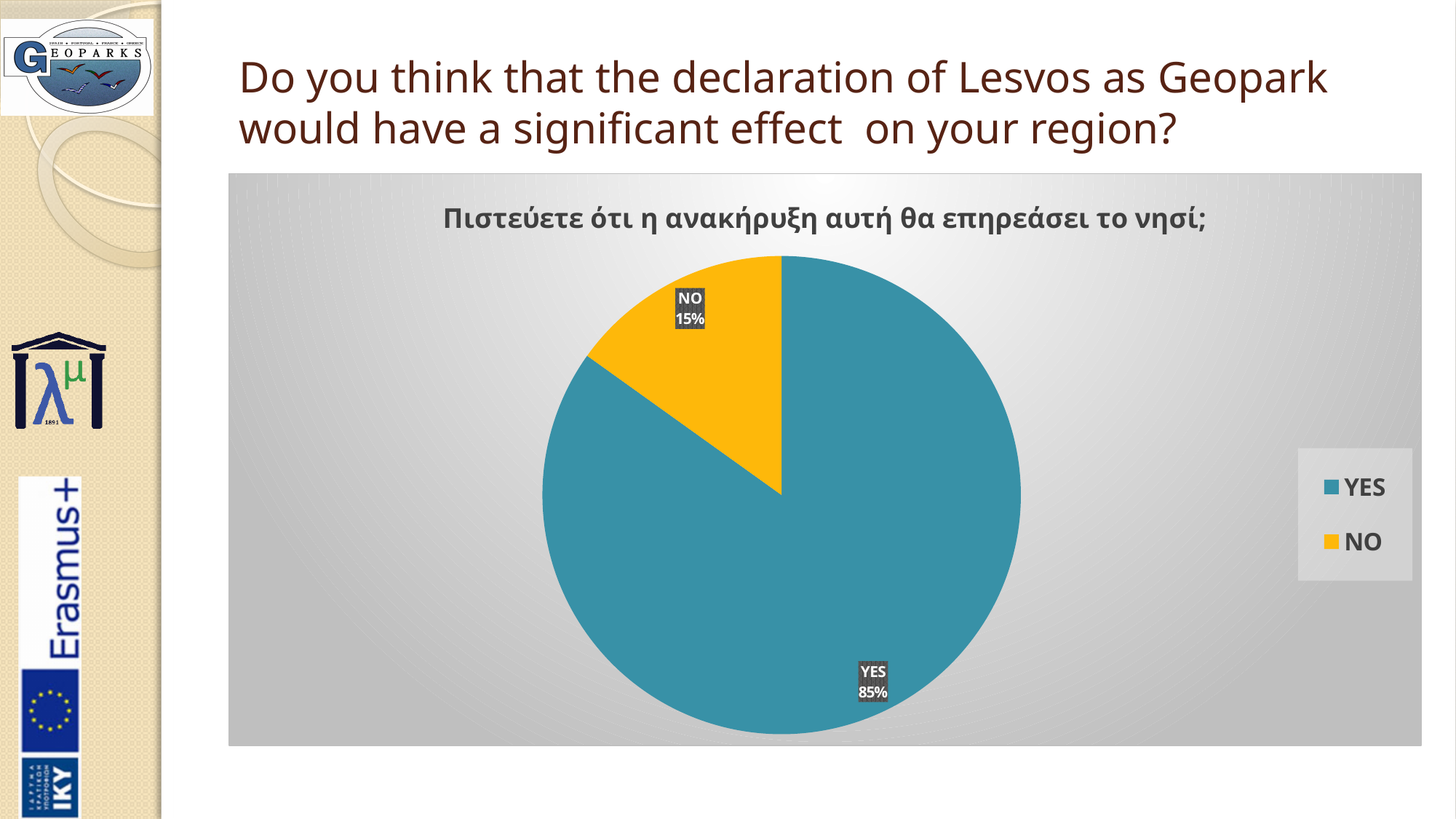
What colour is the YES slice? teal blue Which response has the largest share of the pie? YES What kind of chart is shown on the slide? pie chart Which response has the smallest share of the pie? NO What percentage of respondents answered NO? 15% What is the difference in percentage points between the YES and NO shares? 70 What percentage of respondents answered YES? 85% Which is larger, the YES share or the NO share? YES What share of the pie does the NO slice represent? 15% How many entries does the legend list? 2 How many slices does the pie chart have? 2 What colour is the NO slice? yellow